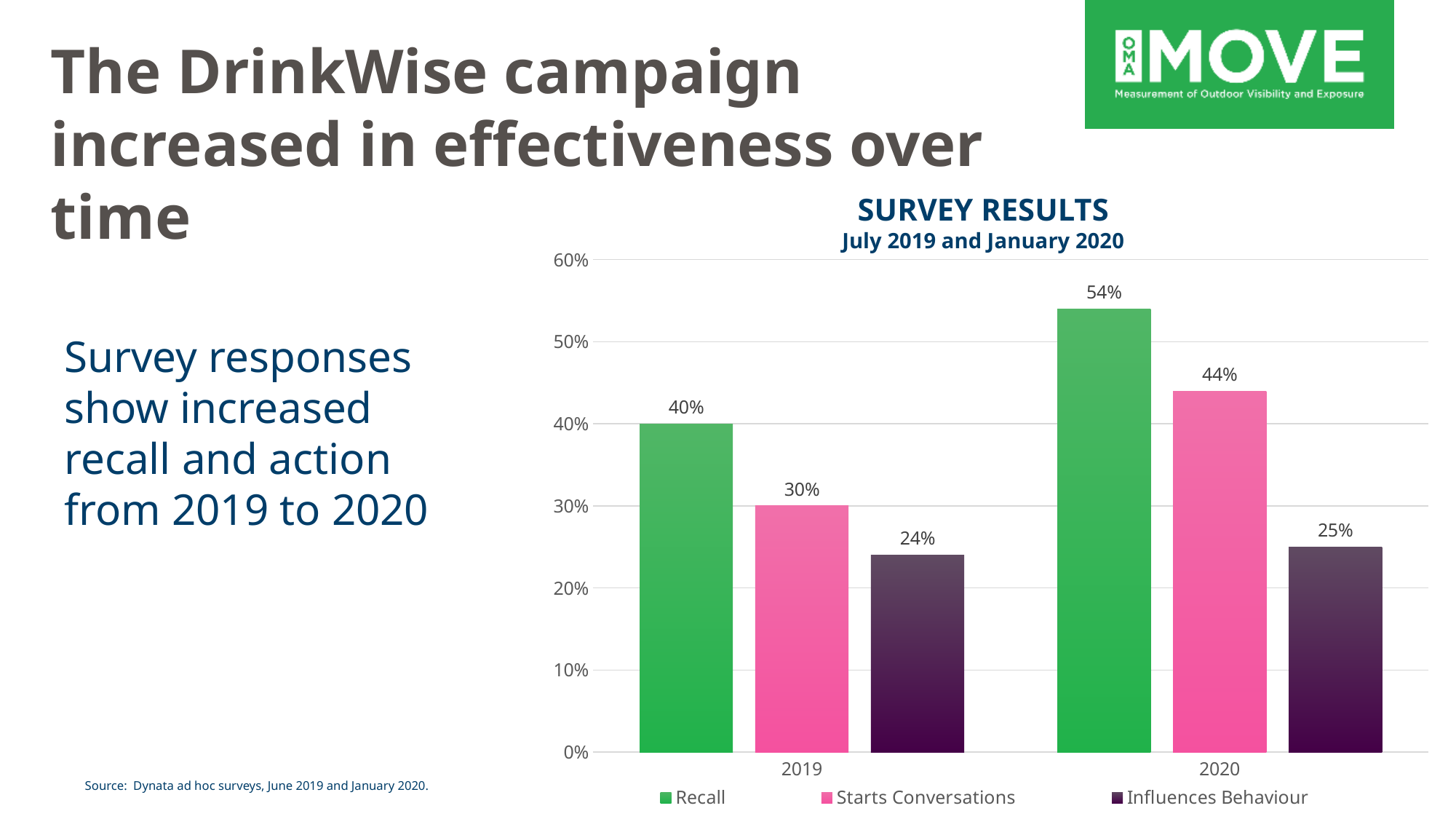
Which series has the lowest value in 2019? Influences Behaviour What is the title of the chart? SURVEY RESULTS By how many percentage points did Recall increase from 2019 to 2020? 14 percentage points How many series does the legend list? 3 What is the Starts Conversations value for 2020? 44% What is the Influences Behaviour value for 2019? 24% What is the Recall value for 2020? 54% What kind of chart is shown on the slide? Bar chart How many year categories are shown on the x axis? 2 Which series has the highest value in 2020? Recall What is the Recall value for 2019? 40% Which is larger: Starts Conversations in 2019 or Starts Conversations in 2020? Starts Conversations in 2020